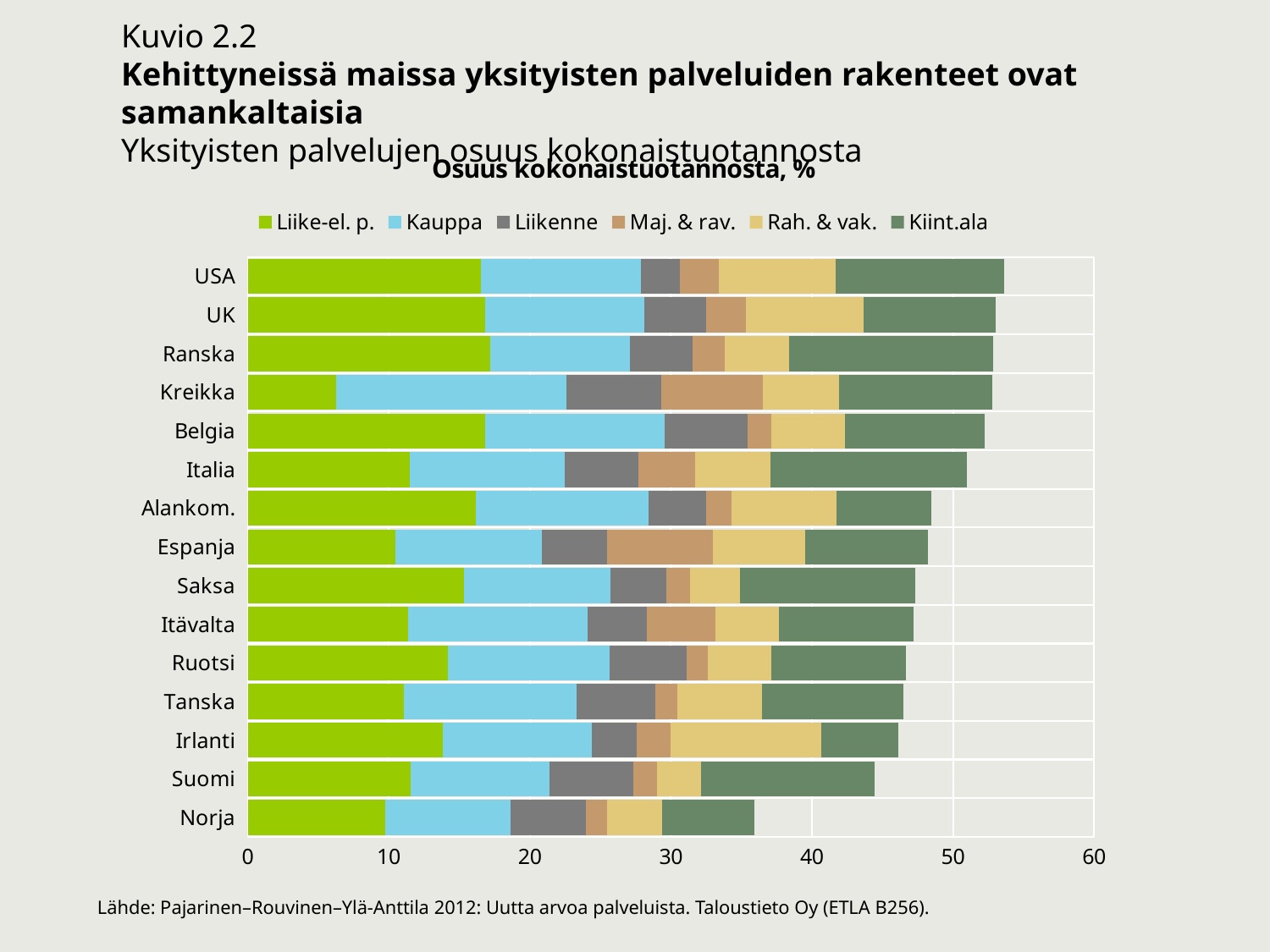
Which country has the lowest total share of private services in total output? Norja How many series does the legend list? 6 Do the total bar lengths increase or decrease going from USA at the top to Norja at the bottom? decrease Is the total value for Suomi greater or less than 50? less Is the total value for Norja greater or less than 40? less What kind of chart is shown on the slide? stacked bar chart What is the title printed above the chart's legend? Osuus kokonaistuotannosta, % How many countries are listed on the chart? 15 Which has the larger total bar, Suomi or Norja? Suomi Is the total value for USA greater or less than 50? greater Which has the larger Liike-el. p. segment, USA or Kreikka? USA